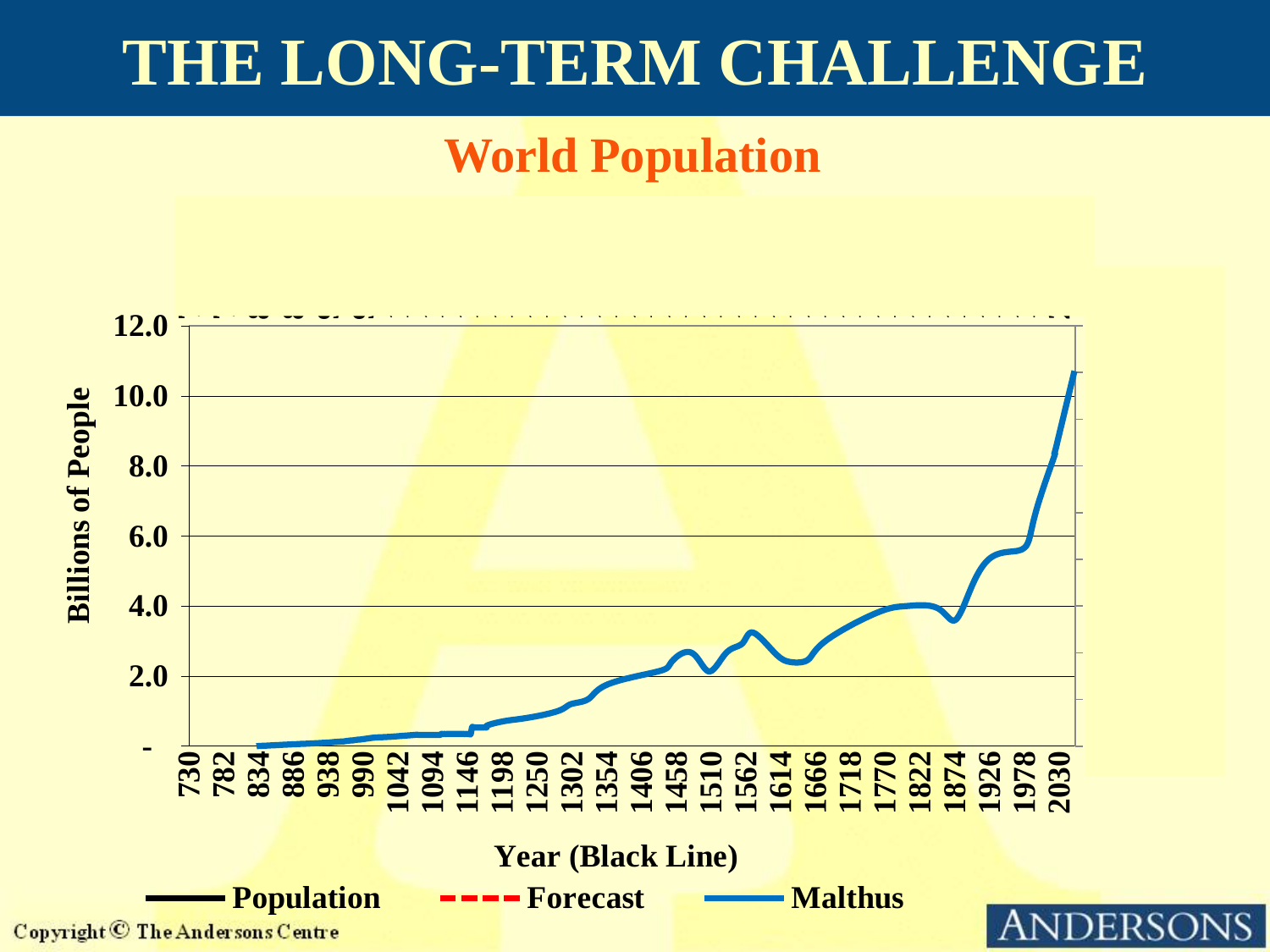
What is the label on the vertical axis? Billions of People Is the Malthus value at 1978 greater or less than 6.0? less What is the highest value shown on the vertical axis? 12.0 Does the Malthus line generally rise or fall from left to right along the x axis? rise How many series does the legend list? 3 What kind of chart is shown on the slide? line chart Is the Malthus value at 1718 greater or less than 4.0? less Is the Malthus value at 1250 greater or less than 2.0? less What is the title of the chart? World Population Is the Malthus value at 1926 larger or smaller than the value at 1562? larger